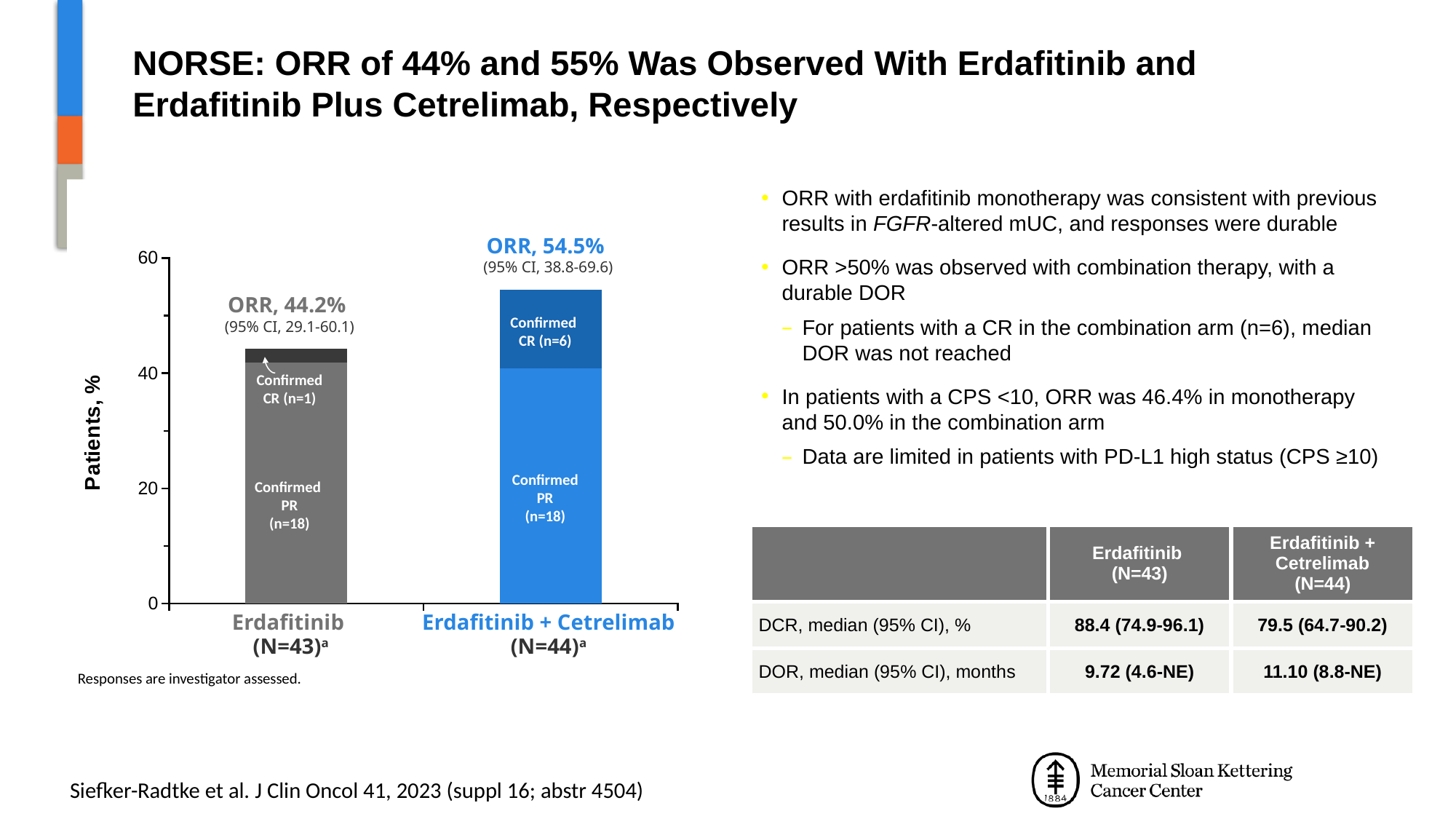
What type of chart is shown on the slide? Stacked bar chart Is the ORR for Erdafitinib greater or less than 40? greater What is the difference in ORR between the Erdafitinib + Cetrelimab bar and the Erdafitinib bar? 10.3% Which arm has the higher ORR in the chart? Erdafitinib + Cetrelimab How many more confirmed CRs were there in the Erdafitinib + Cetrelimab arm than in the Erdafitinib arm? 5 What is the 95% CI printed for the ORR of Erdafitinib + Cetrelimab? 38.8-69.6 How many treatment arms (bars) are plotted in the chart? 2 How many patients had a confirmed PR in the Erdafitinib arm according to the chart? n=18 How many patients had a confirmed CR in the Erdafitinib + Cetrelimab arm according to the chart? n=6 What is the ORR shown for the Erdafitinib bar? 44.2% What is the ORR shown for the Erdafitinib + Cetrelimab bar? 54.5% What is the label of the y-axis of the chart? Patients, %